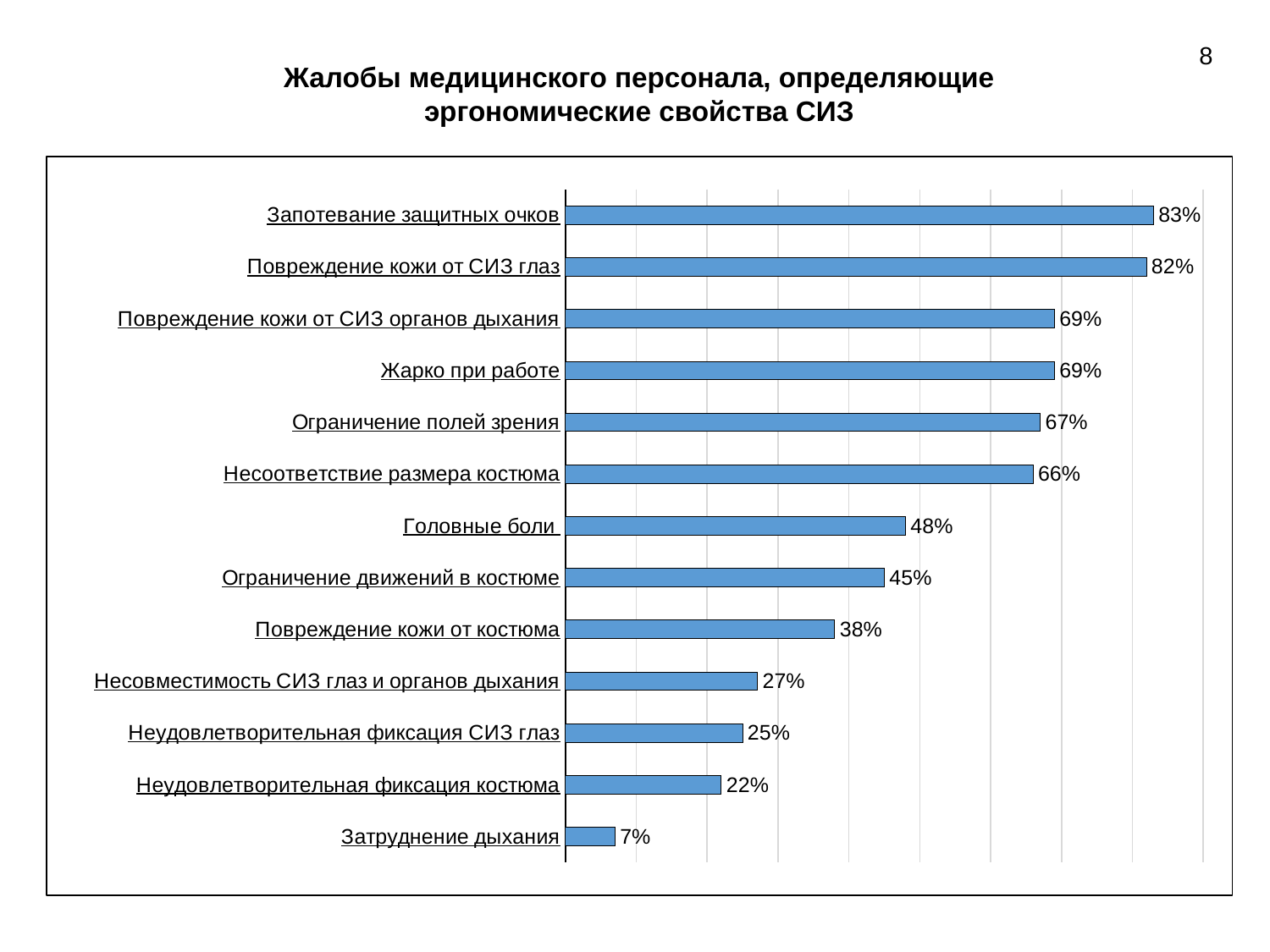
How many categories are shown in the chart? 13 Which is larger: the value for Повреждение кожи от костюма or the value for Несовместимость СИЗ глаз и органов дыхания? Повреждение кожи от костюма What colour are the bars in the chart? Blue What is the title of the slide? Жалобы медицинского персонала, определяющие эргономические свойства СИЗ Which category has the lowest value? Затруднение дыхания What is the value for Запотевание защитных очков? 83% What is the difference between the values for Ограничение полей зрения and Ограничение движений в костюме? 22% What is the difference between the values for Запотевание защитных очков and Затруднение дыхания? 76% What kind of chart is shown on the slide? Bar chart Which category has the highest value? Запотевание защитных очков What is the value for Головные боли? 48% What is the value for Неудовлетворительная фиксация костюма? 22%